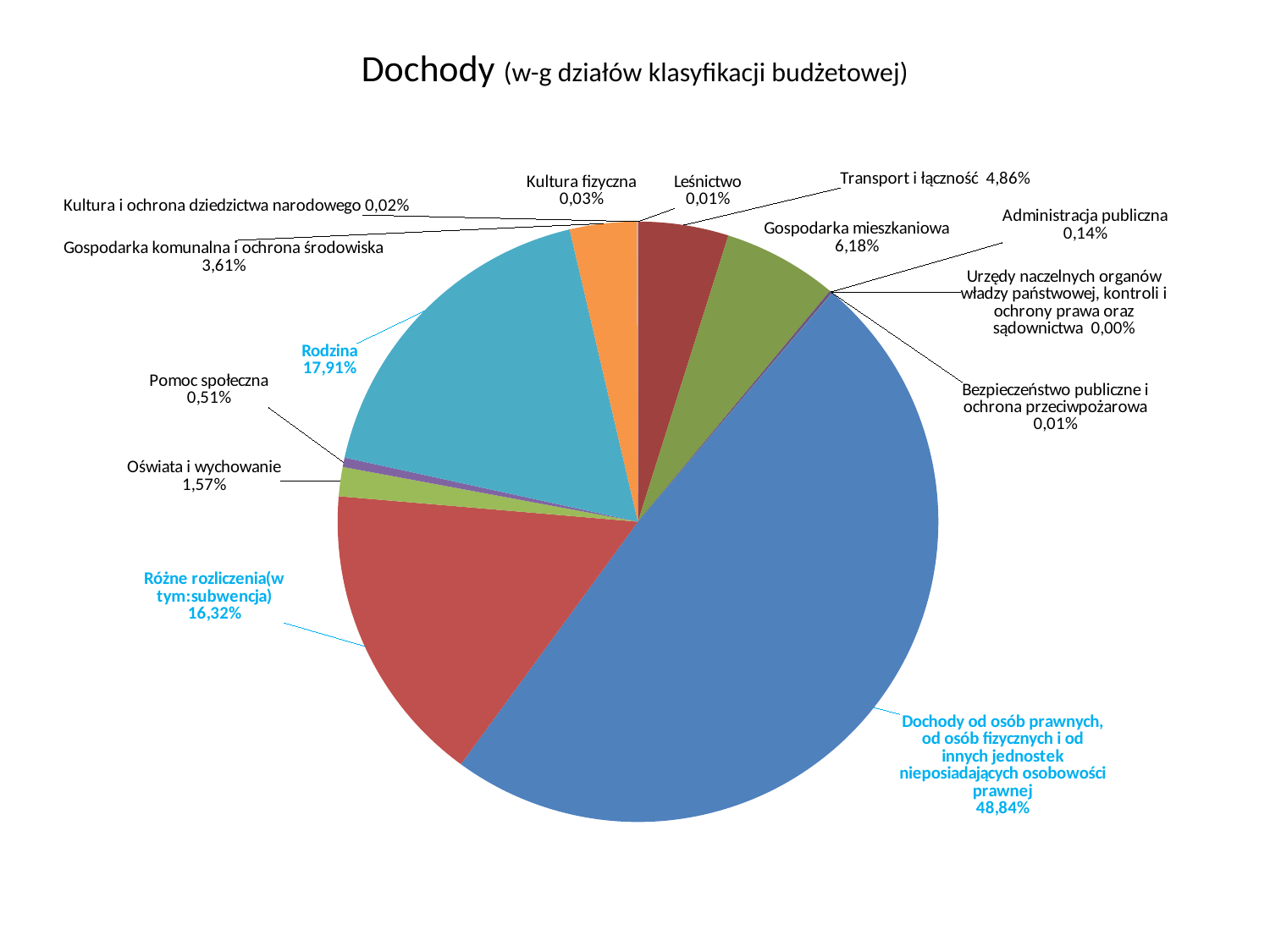
What is the value shown for Transport i łączność? 4,86% Which is larger: Rodzina or Różne rozliczenia (w tym: subwencja)? Rodzina How many categories are shown in the pie chart? 14 What type of chart is shown on the slide? Pie chart Which category has the largest share of the pie? Dochody od osób prawnych, od osób fizycznych i od innych jednostek nieposiadających osobowości prawnej What is the value shown for Gospodarka mieszkaniowa? 6,18% What is the value shown for Gospodarka komunalna i ochrona środowiska? 3,61% What is the title of the chart? Dochody (w-g działów klasyfikacji budżetowej) Which category has the smallest share of the pie? Urzędy naczelnych organów władzy państwowej, kontroli i ochrony prawa oraz sądownictwa What is the value shown for Oświata i wychowanie? 1,57% What is the difference in percentage points between Rodzina and Różne rozliczenia (w tym: subwencja)? 1,59 What share of the pie does Rodzina represent? 17,91%